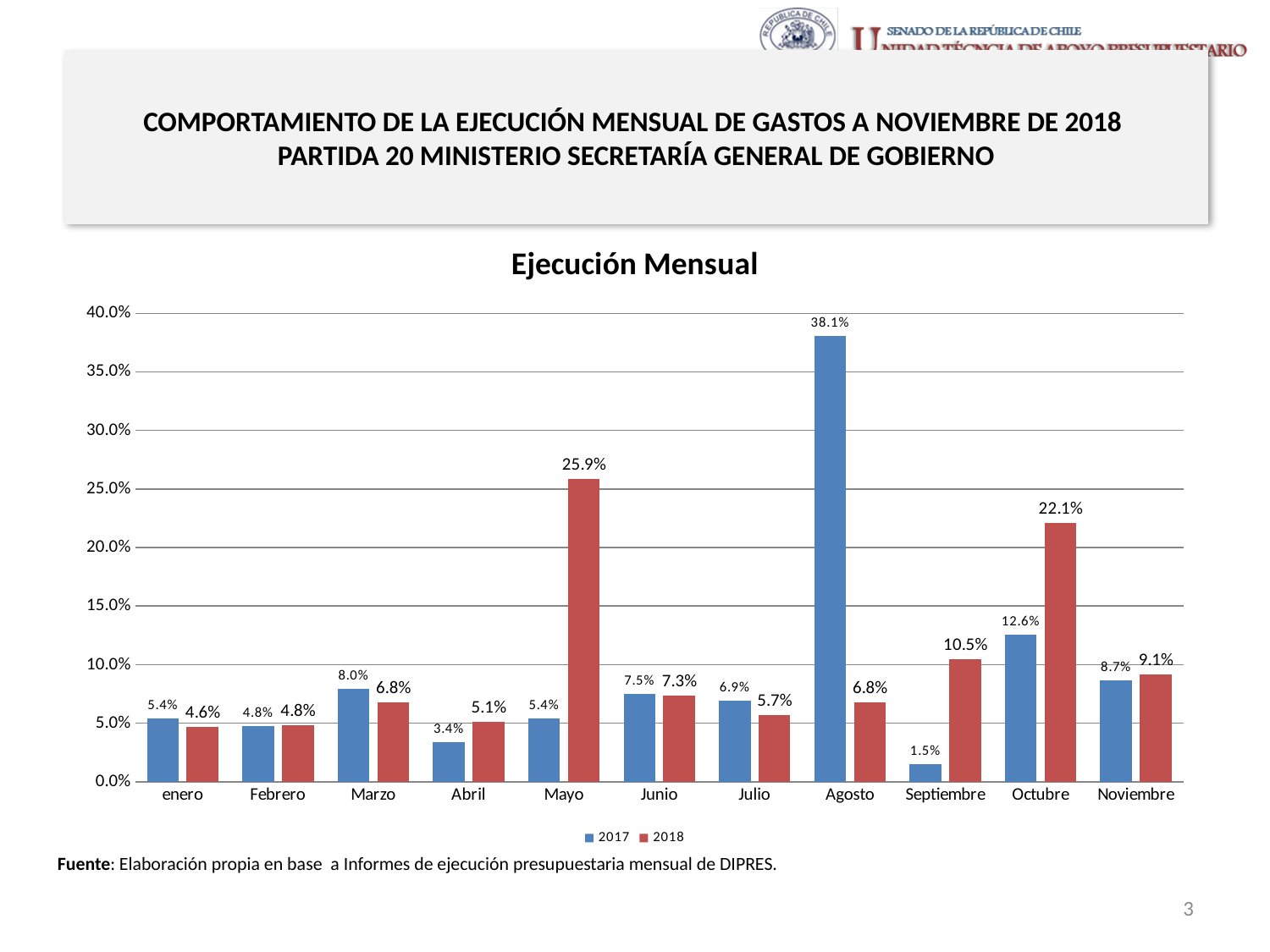
In Marzo, which series has the larger value, 2017 or 2018? 2017 Which month has the lowest value for the 2017 series? Septiembre What is the value for 2018 in Mayo? 25.9% Which month has the highest value for the 2018 series? Mayo What type of chart is shown? Bar chart What is the difference between the 2018 and 2017 values in Octubre? 9.5% How many series does the legend list? 2 What is the value for 2017 in Agosto? 38.1% What is the value for 2017 in Septiembre? 1.5% How many months are shown on the x axis? 11 Which month has the highest value for the 2017 series? Agosto What is the value for 2018 in Octubre? 22.1%